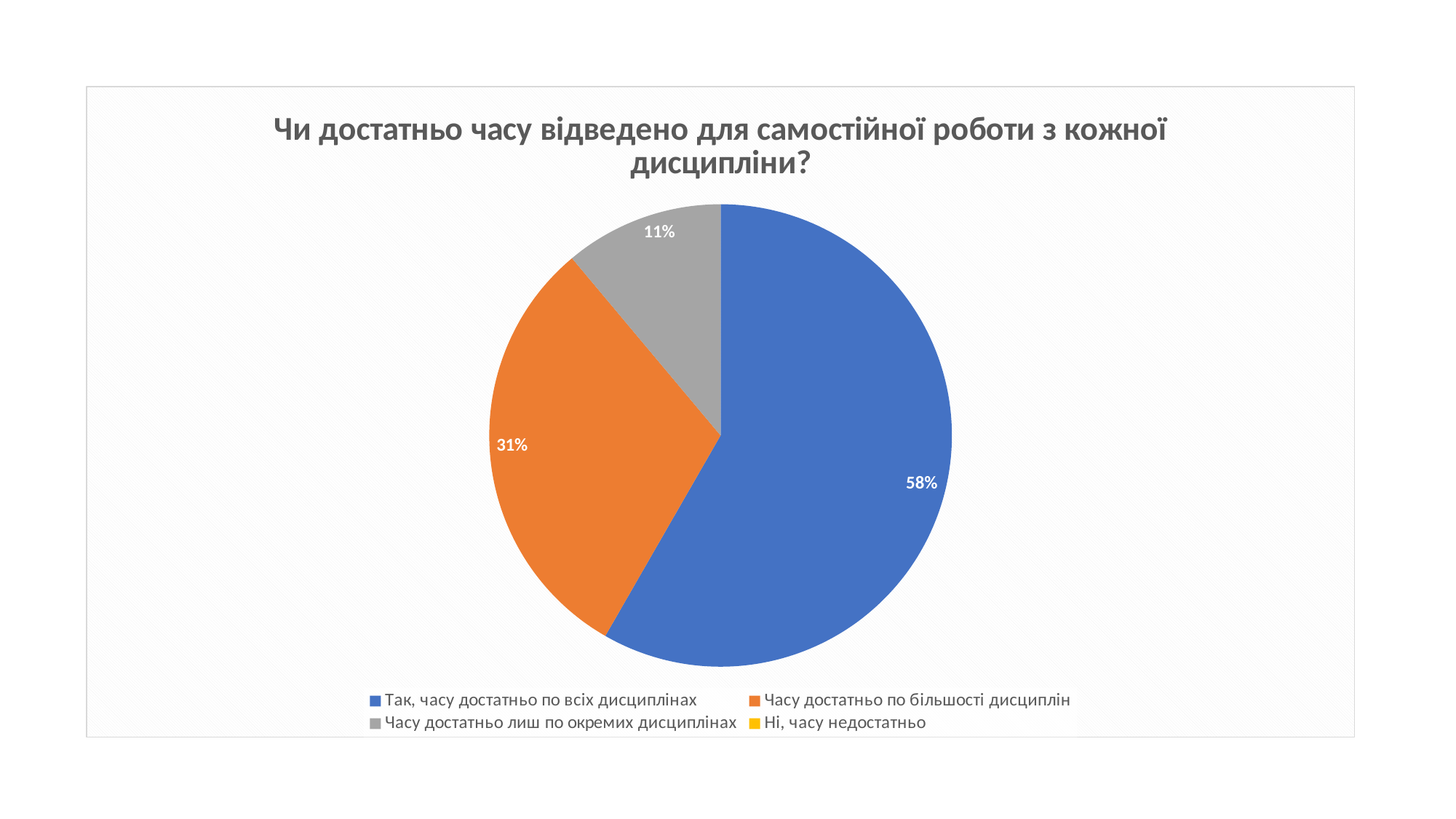
What percentage of the pie is the slice for "Так, часу достатньо по всіх дисциплінах"? 58% What colour is the slice for "Часу достатньо лиш по окремих дисциплінах"? grey What share of the pie does the blue slice represent? 58% What is the difference in percentage points between the "Так, часу достатньо по всіх дисциплінах" slice and the "Часу достатньо по більшості дисциплін" slice? 27 What percentage is shown for "Часу достатньо по більшості дисциплін"? 31% What kind of chart is shown on the slide? pie chart What is the title of the chart? Чи достатньо часу відведено для самостійної роботи з кожної дисципліни? What is the difference in percentage points between the "Часу достатньо по більшості дисциплін" slice and the "Часу достатньо лиш по окремих дисциплінах" slice? 20 What percentage is shown for "Часу достатньо лиш по окремих дисциплінах"? 11% Which category has the largest slice of the pie? Так, часу достатньо по всіх дисциплінах Which is larger: the slice for "Часу достатньо по більшості дисциплін" or the slice for "Часу достатньо лиш по окремих дисциплінах"? Часу достатньо по більшості дисциплін How many entries does the legend list? 4